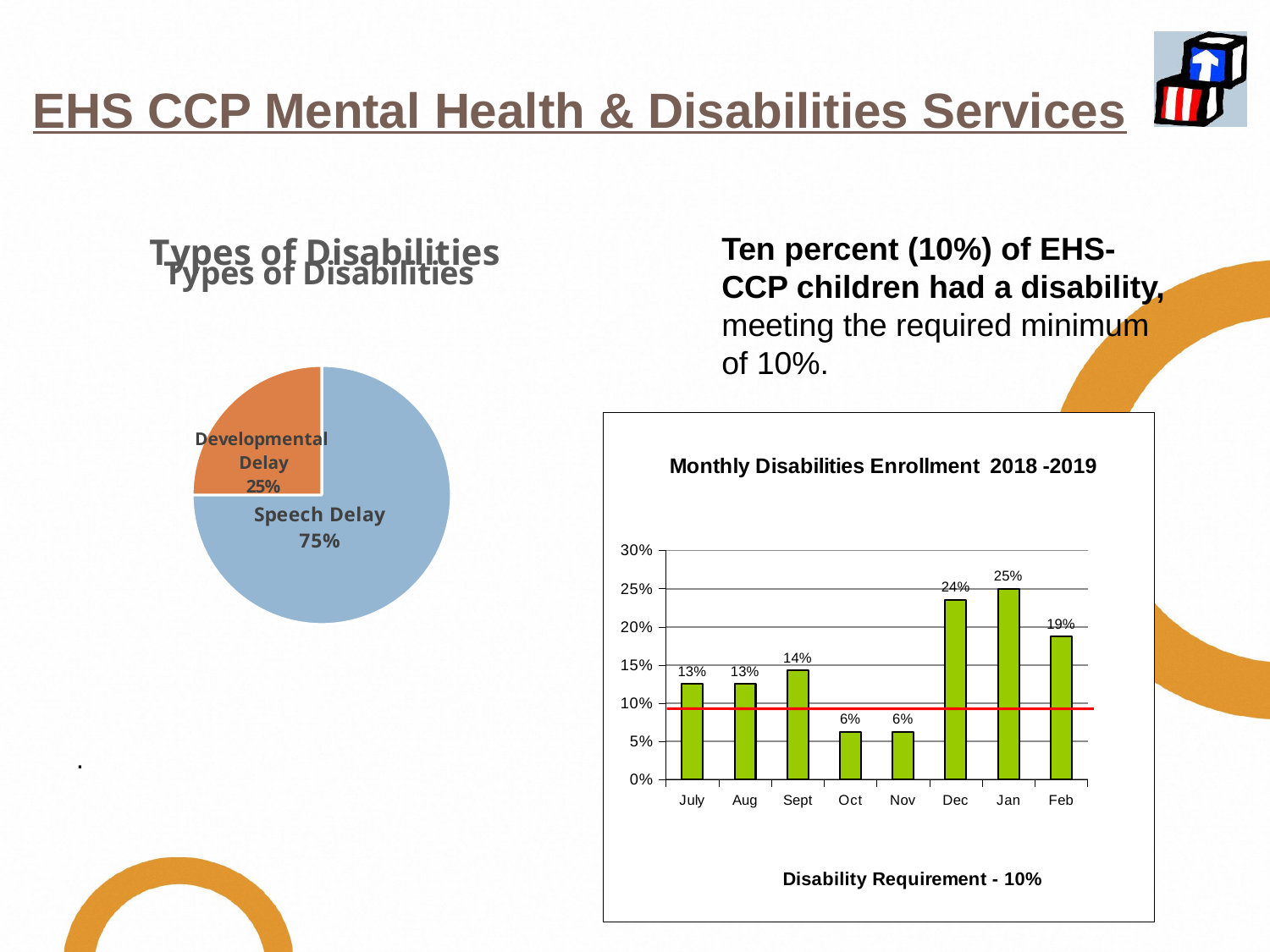
How many months are shown in the 'Monthly Disabilities Enrollment 2018-2019' chart? 8 In the 'Monthly Disabilities Enrollment 2018-2019' chart, what is the value for Sept? 14% What kind of chart is 'Monthly Disabilities Enrollment 2018-2019'? Bar chart What kind of chart is 'Types of Disabilities'? Pie chart In the 'Monthly Disabilities Enrollment 2018-2019' chart, what does the red horizontal line represent? Disability Requirement - 10% In the 'Monthly Disabilities Enrollment 2018-2019' chart, which is larger, the value for Sept or the value for Oct? Sept In the 'Types of Disabilities' pie chart, what share does Developmental Delay have? 25% How many slices does the 'Types of Disabilities' pie chart have? 2 In the 'Types of Disabilities' pie chart, what share does Speech Delay have? 75% In the 'Monthly Disabilities Enrollment 2018-2019' chart, which month has the highest value? Jan In the 'Monthly Disabilities Enrollment 2018-2019' chart, what is the difference between Jan and Feb? 6% In the 'Monthly Disabilities Enrollment 2018-2019' chart, what is the value for Dec? 24%